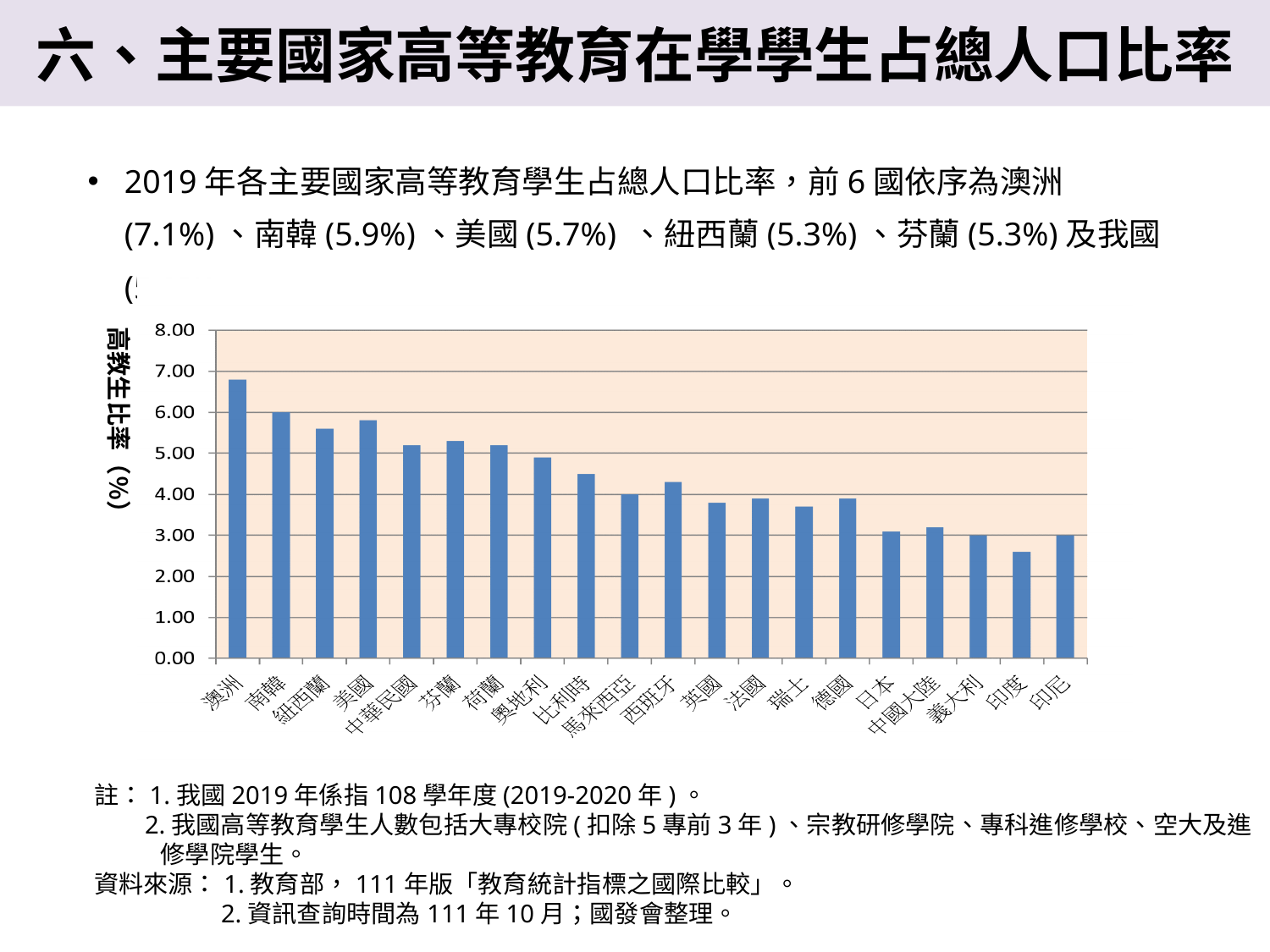
Is the value for 印度 greater or less than 3.00? less Is the value for 比利時 greater or less than 4.00? greater What kind of chart is shown on the slide? bar chart Is the value for 瑞士 greater or less than 4.00? less Do the bar values generally rise or fall moving from left to right along the x axis? fall How many countries/regions are shown on the x axis of the chart? 20 Which country has the highest bar in the chart? 澳洲 Which country has the lowest bar in the chart? 印度 Which has the larger value, 南韓 or 英國? 南韓 What is the label on the vertical axis of the chart? 高教生比率(%)